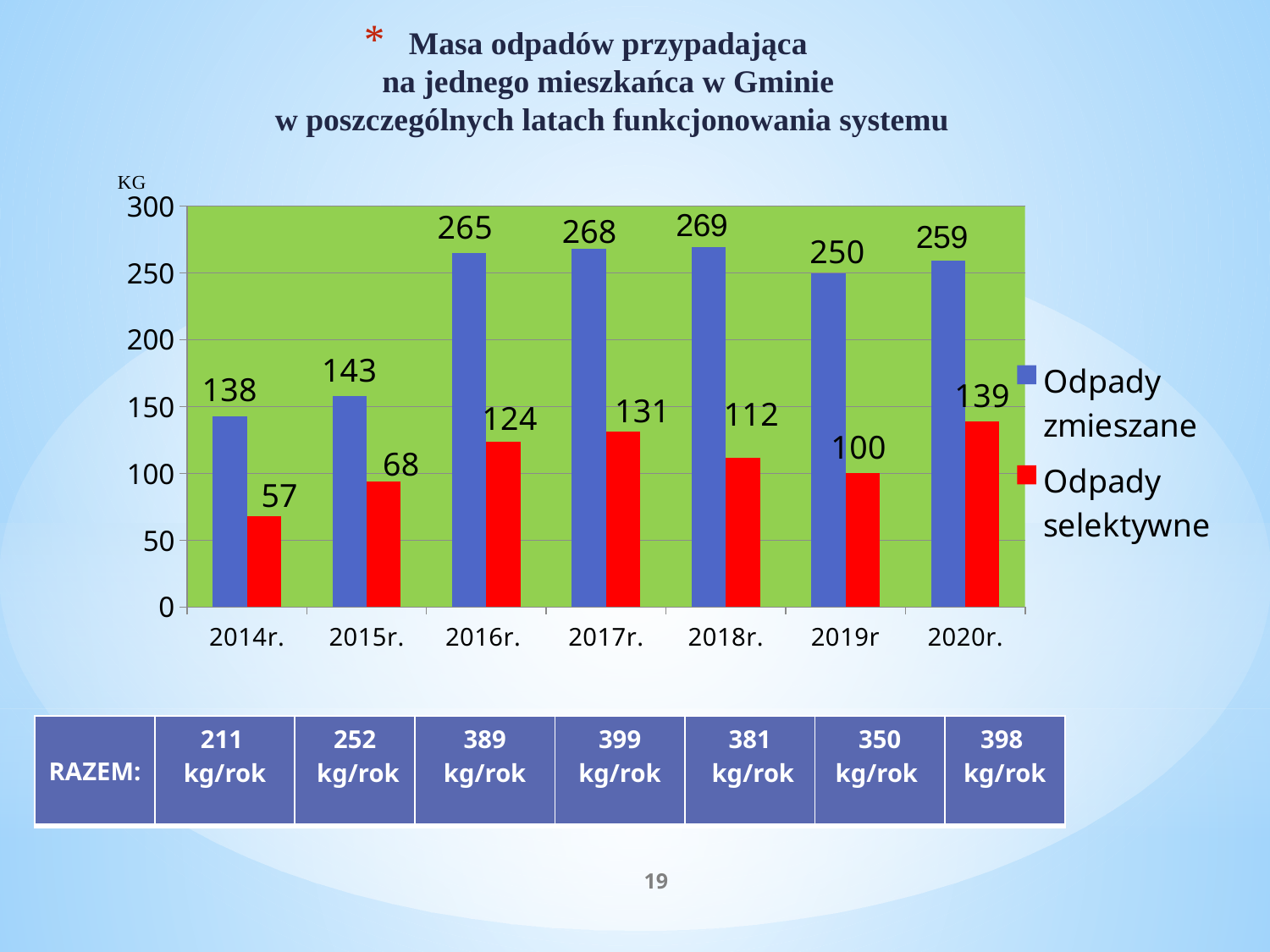
What is the difference between Odpady zmieszane and Odpady selektywne in 2017r.? 137 Is the value for Odpady zmieszane in 2020r. greater or less than 200? greater What kind of chart is shown on the slide? bar chart What is the value for Odpady selektywne in 2020r.? 139 In which year is the value for Odpady selektywne the lowest? 2014r. How many series does the legend list? 2 In which year is the value for Odpady zmieszane the highest? 2018r. Which is larger in 2019r: Odpady zmieszane or Odpady selektywne? Odpady zmieszane What is the value for Odpady zmieszane in 2016r.? 265 What is the value for Odpady selektywne in 2014r.? 57 How many years are shown on the x axis of the chart? 7 What colour are the bars for Odpady selektywne? red